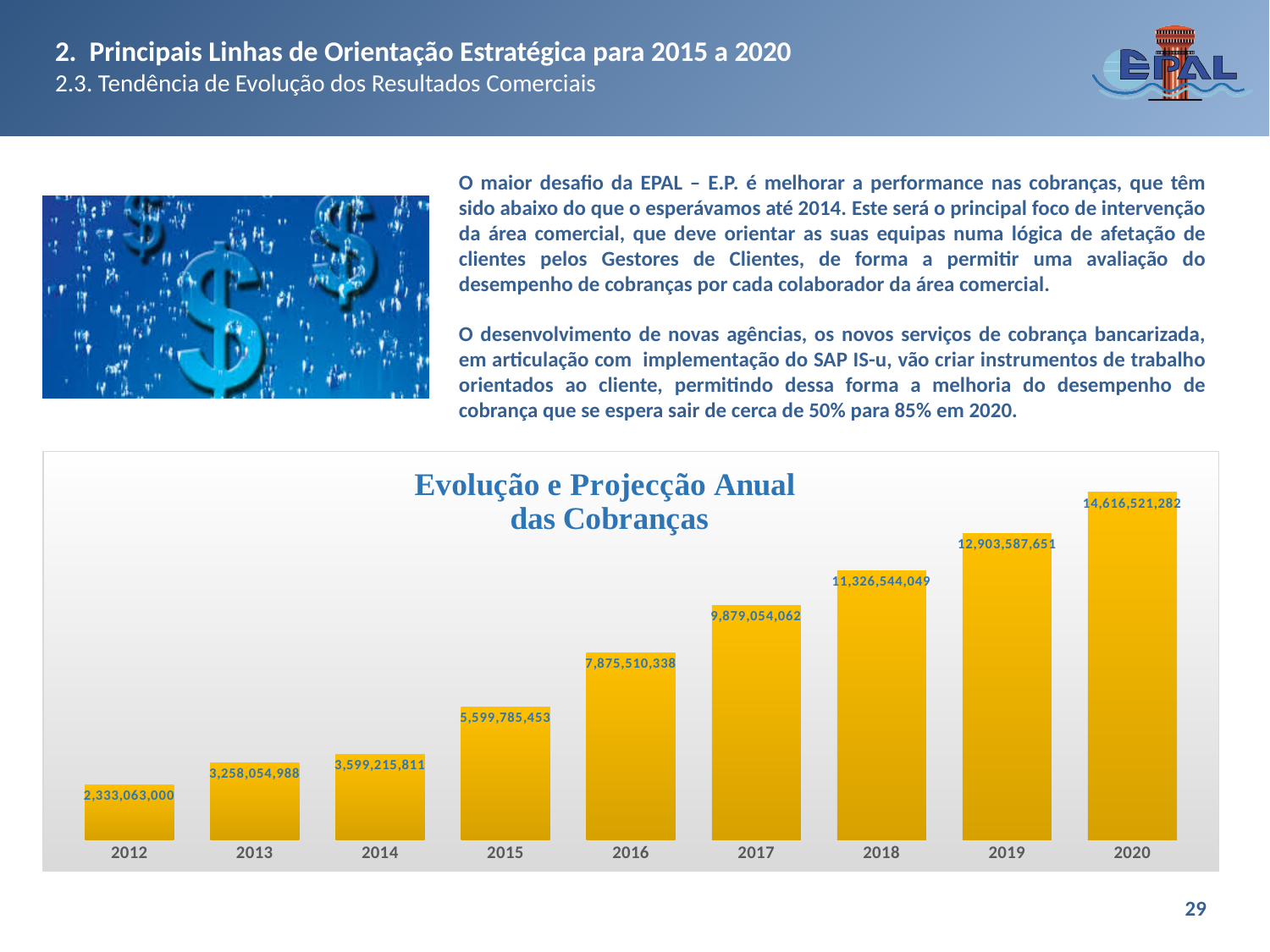
What is the difference between the values for 2020 and 2012? 12,283,458,282 Which year has the highest value in the chart? 2020 What is the value for 2018 in the chart? 11,326,544,049 What is the difference between the values for 2016 and 2015? 2,275,724,885 Which year has the lowest value in the chart? 2012 How many years are shown on the x axis of the chart? 9 What kind of chart is shown on the slide? Bar chart Which is larger, the value for 2017 or the value for 2019? 2019 What is the value for 2020 in the chart? 14,616,521,282 What is the value for 2012 in the chart 'Evolução e Projecção Anual das Cobranças'? 2,333,063,000 Do the values rise or fall from 2012 to 2020? Rise What is the value for 2016 in the chart? 7,875,510,338